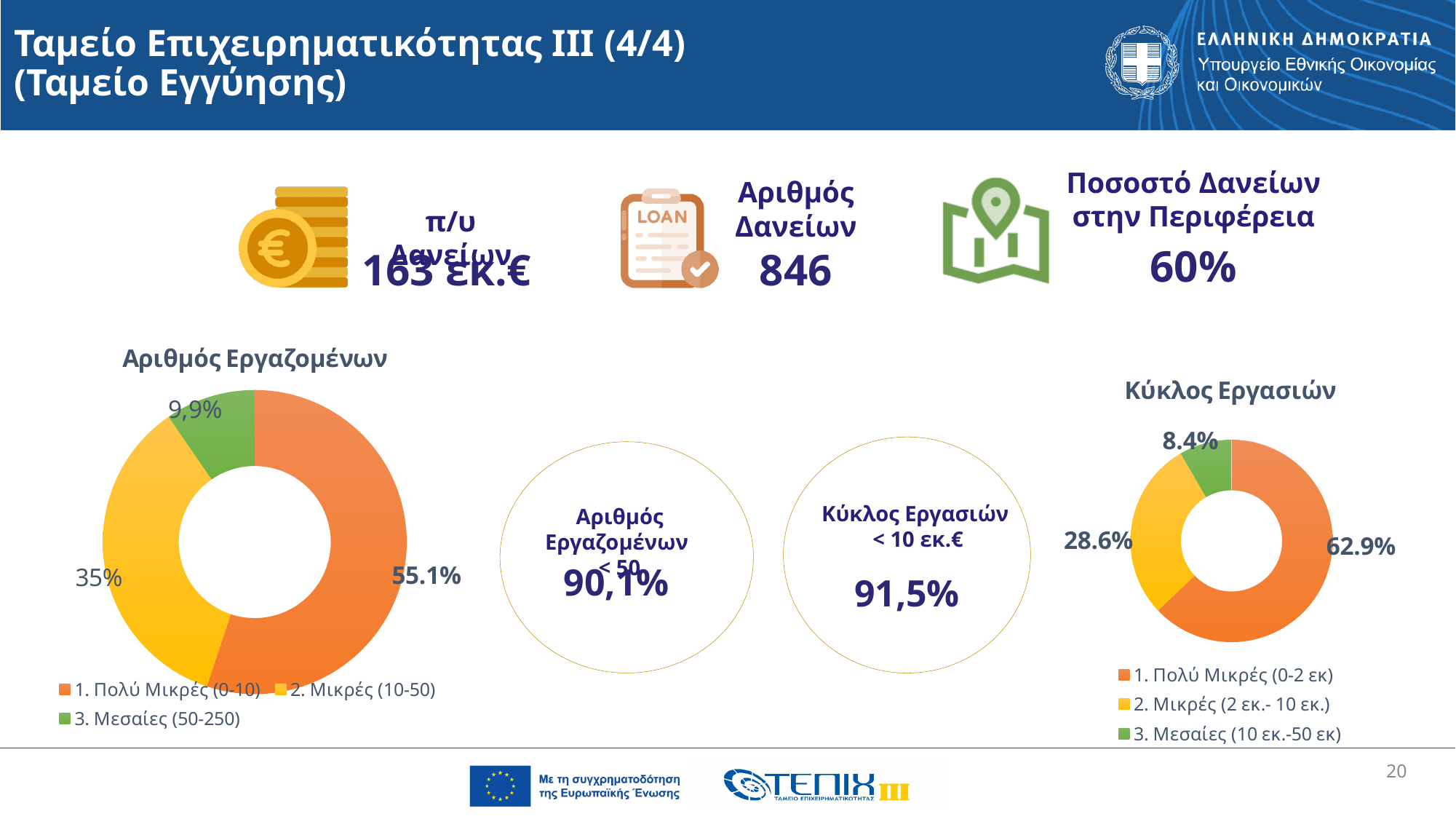
How many categories does the 'Κύκλος Εργασιών' chart show? 3 In the 'Κύκλος Εργασιών' chart, what is the value for '1. Πολύ Μικρές (0-2 εκ)'? 62.9% In the 'Αριθμός Εργαζομένων' chart, which is larger: the share of '2. Μικρές (10-50)' or '3. Μεσαίες (50-250)'? 2. Μικρές (10-50) In the 'Κύκλος Εργασιών' chart, which category has the largest share? 1. Πολύ Μικρές (0-2 εκ) In the 'Αριθμός Εργαζομένων' chart, what is the value for '2. Μικρές (10-50)'? 35% In the 'Αριθμός Εργαζομένων' chart, what is the value for '3. Μεσαίες (50-250)'? 9,9% In the 'Αριθμός Εργαζομένων' chart, which category has the smallest share? 3. Μεσαίες (50-250) In the 'Κύκλος Εργασιών' chart, what is the value for '3. Μεσαίες (10 εκ.-50 εκ)'? 8.4% In the 'Κύκλος Εργασιών' chart, what is the difference between the shares of '1. Πολύ Μικρές (0-2 εκ)' and '2. Μικρές (2 εκ.- 10 εκ.)'? 34.3% In the 'Αριθμός Εργαζομένων' chart, what is the value for '1. Πολύ Μικρές (0-10)'? 55.1% What kind of chart is the 'Αριθμός Εργαζομένων' chart? Doughnut chart In the 'Κύκλος Εργασιών' chart, what colour is the '3. Μεσαίες (10 εκ.-50 εκ)' slice? Green